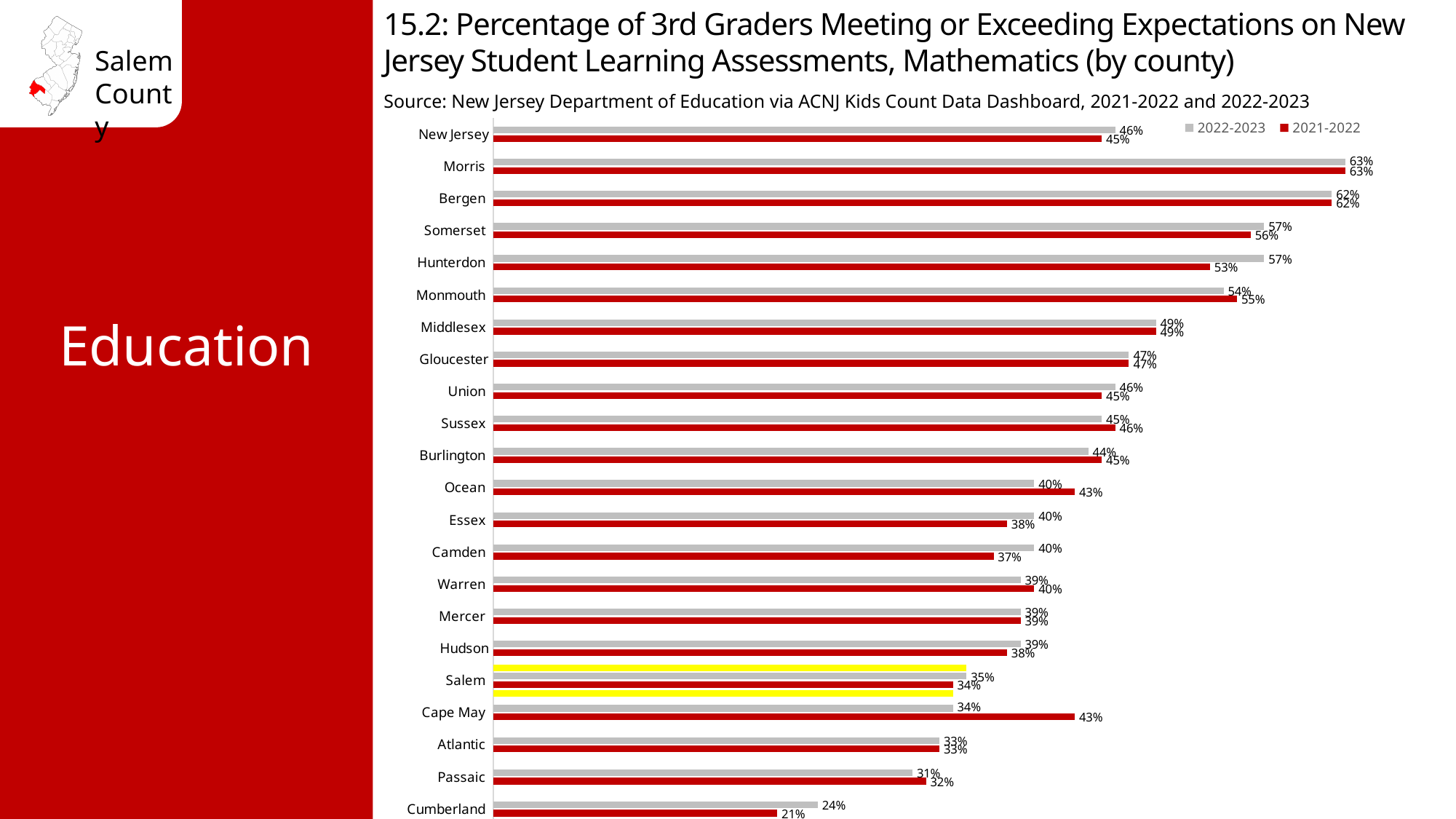
Which county had the lowest 2021-2022 value? Cumberland How many series does the legend list? 2 What is the difference between the 2022-2023 and 2021-2022 values for Cape May? 9% What is the difference between the 2022-2023 values for Morris and Cumberland? 39% Which series is shown in red in the legend? 2021-2022 What was the 2022-2023 value for Salem? 35% What was the 2022-2023 value for Hunterdon? 57% Which county had the highest 2022-2023 value? Morris What kind of chart is shown on the slide? Bar chart Which is larger, the 2021-2022 value for Ocean or the 2021-2022 value for Essex? Ocean How many counties or regions are listed on the chart? 22 What was the 2021-2022 value for Cape May? 43%